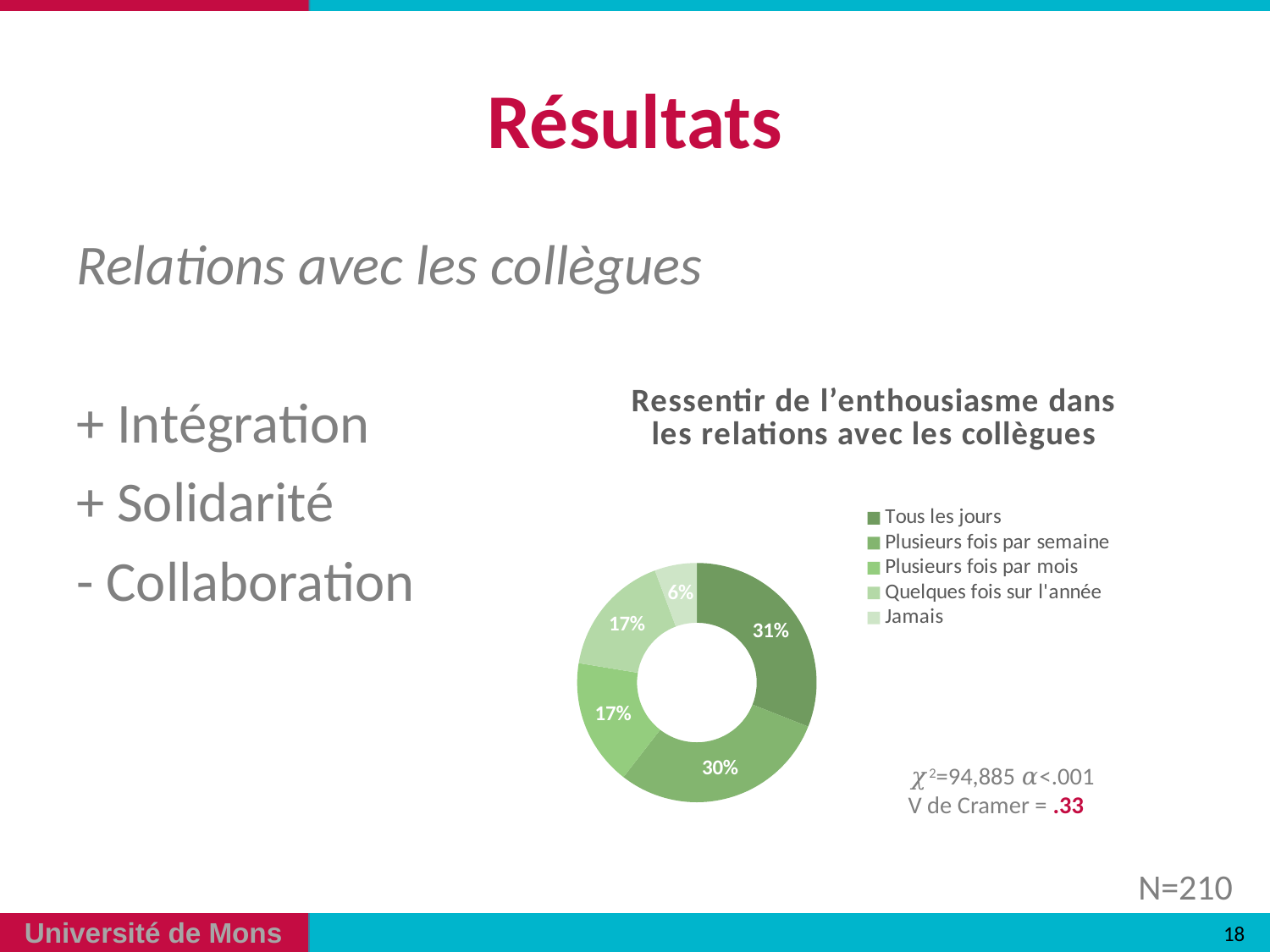
What share of the pie chart corresponds to "Plusieurs fois par semaine"? 30% What is the difference in percentage points between "Tous les jours" and "Jamais"? 25 Which category has the largest slice of the pie chart? Tous les jours How many slices does the pie chart have? 5 What percentage is shown for "Plusieurs fois par mois"? 17% How many entries does the legend of the chart list? 5 What percentage of the pie chart is labelled "Tous les jours"? 31% What percentage does the "Jamais" slice show? 6% What type of chart is shown on the slide? Doughnut chart Which is larger, the slice for "Plusieurs fois par semaine" or the slice for "Quelques fois sur l'année"? Plusieurs fois par semaine Which category has the smallest slice of the pie chart? Jamais What is the title of the chart on the slide? Ressentir de l'enthousiasme dans les relations avec les collègues